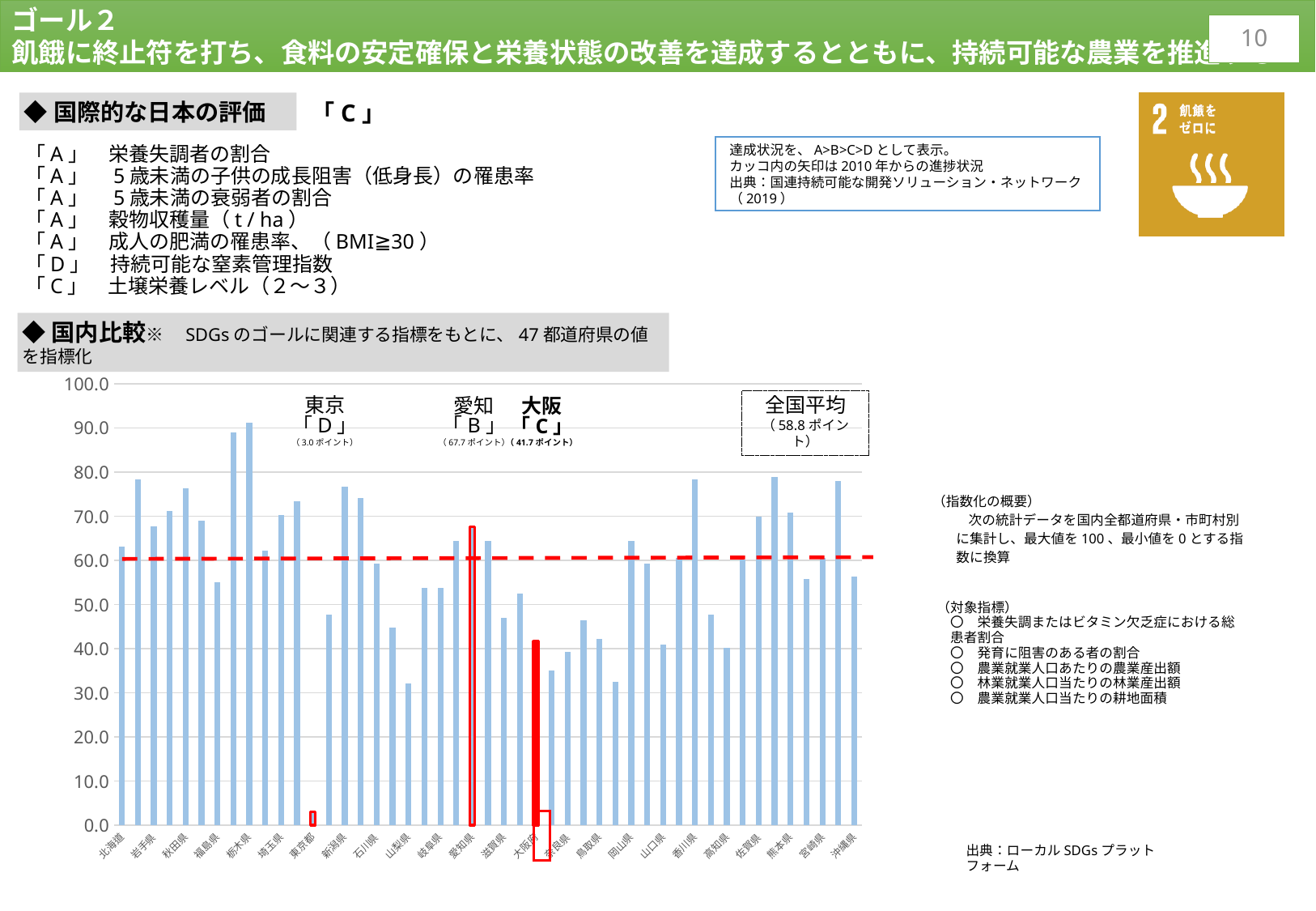
In the 国内比較 bar chart, what is the difference between the printed values for 愛知 and 大阪? 26.0 ポイント In the 国内比較 bar chart, what is the difference between the printed values for 大阪 and 東京? 38.7 ポイント In the 国内比較 bar chart, what value is printed for 大阪? 41.7 ポイント In the 国内比較 bar chart, what value is printed for 東京? 3.0 ポイント In the 国内比較 bar chart, is the value for 大阪 above or below the 全国平均? below In the 国内比較 bar chart, what value is printed for 愛知? 67.7 ポイント In the 国内比較 bar chart, is the value for 山梨県 greater or less than 50.0? less What kind of chart is used in the 国内比較 section? bar chart In the 国内比較 bar chart, which has the larger value, 愛知 or 大阪? 愛知 In the 国内比較 bar chart, is the value for 栃木県 greater or less than 80.0? greater In the 国内比較 bar chart, which prefecture has the lowest value? 東京都 In the 国内比較 bar chart, what is the 全国平均 value shown? 58.8 ポイント